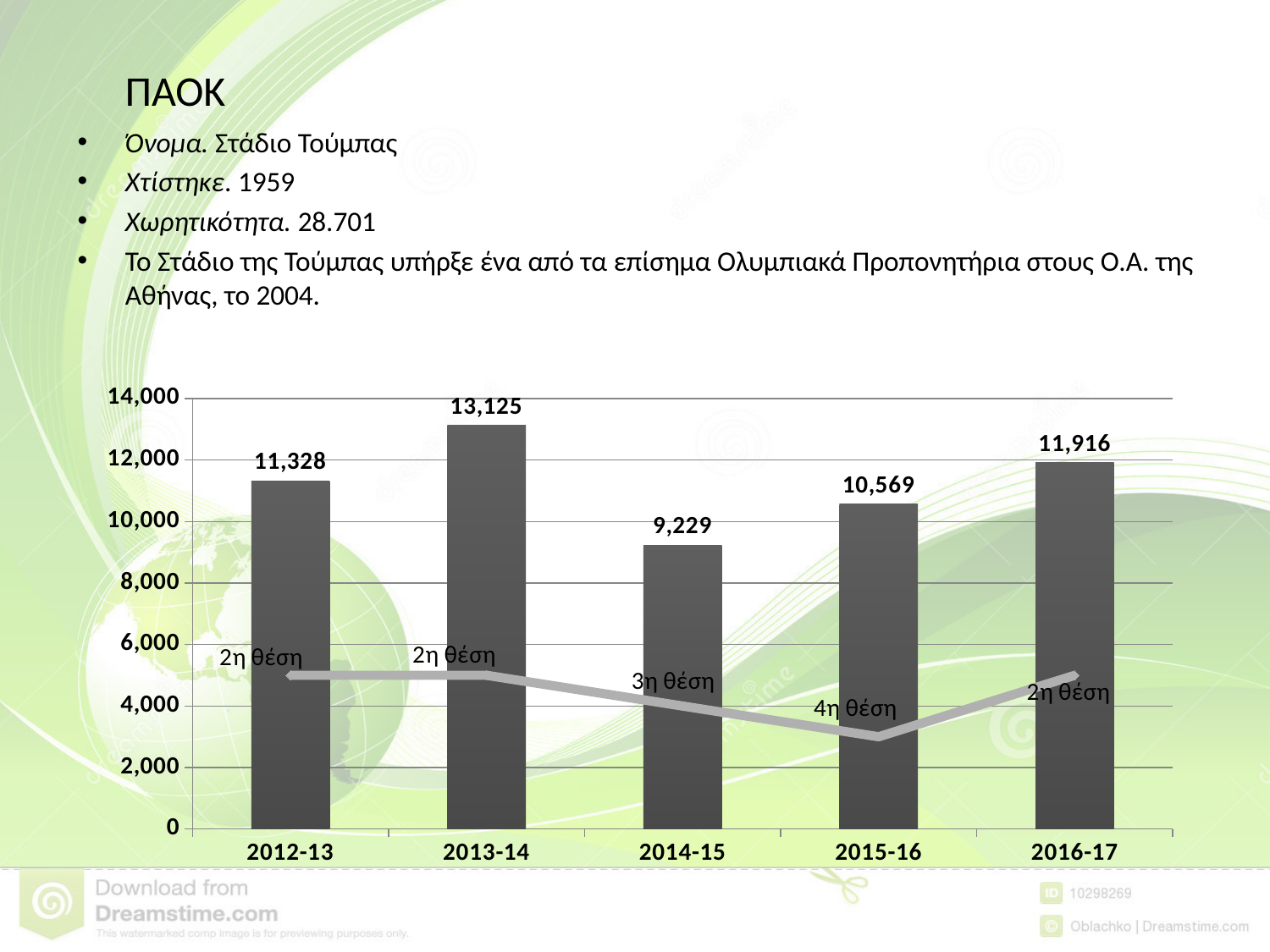
How many seasons are shown on the x axis? 5 What is the value of the bar for 2014-15? 9,229 Which is larger, the bar for 2012-13 or the bar for 2016-17? 2016-17 Which season has the highest bar? 2013-14 What position label is shown on the line for 2015-16? 4η θέση Is the value for 2015-16 greater or less than 12,000? less Do the bar values rise or fall from 2013-14 to 2014-15? fall What is the difference between the bar values for 2016-17 and 2015-16? 1,347 What is the value of the bar for 2013-14? 13,125 What is the value of the bar for 2016-17? 11,916 Which season has the lowest bar? 2014-15 What is the difference between the bar values for 2013-14 and 2014-15? 3,896